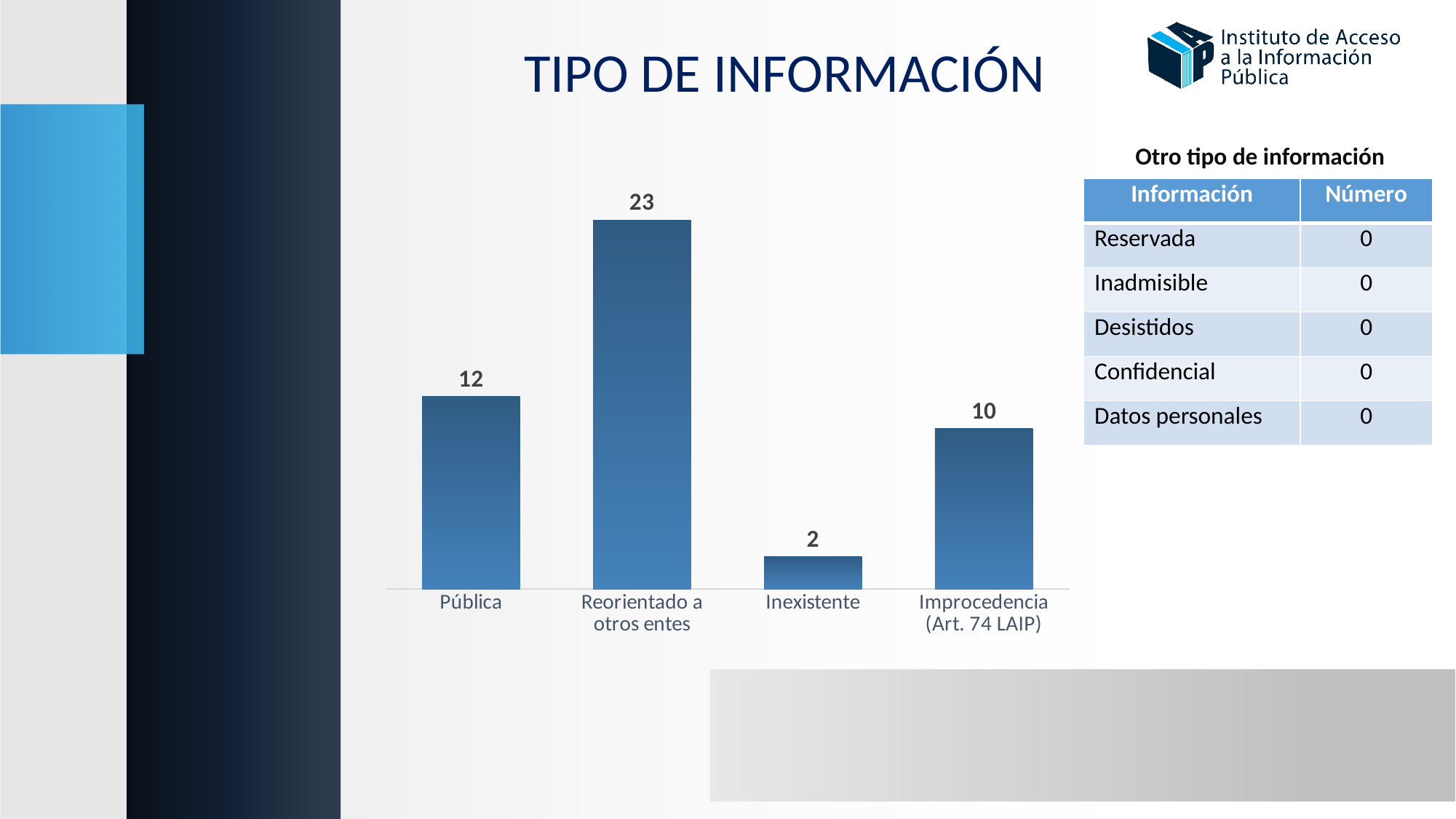
What is the difference between the values for Reorientado a otros entes and Pública? 11 What is the title of the slide containing the chart? TIPO DE INFORMACIÓN Which category has the lowest value? Inexistente What is the value for Improcedencia (Art. 74 LAIP)? 10 How many categories are shown in the bar chart? 4 Which is larger, the value for Pública or the value for Improcedencia (Art. 74 LAIP)? Pública What is the value for Reorientado a otros entes? 23 What is the value for Pública? 12 What is the difference between the values for Improcedencia (Art. 74 LAIP) and Inexistente? 8 What kind of chart is shown on the slide? bar chart What is the value for Inexistente? 2 Which category has the highest value? Reorientado a otros entes